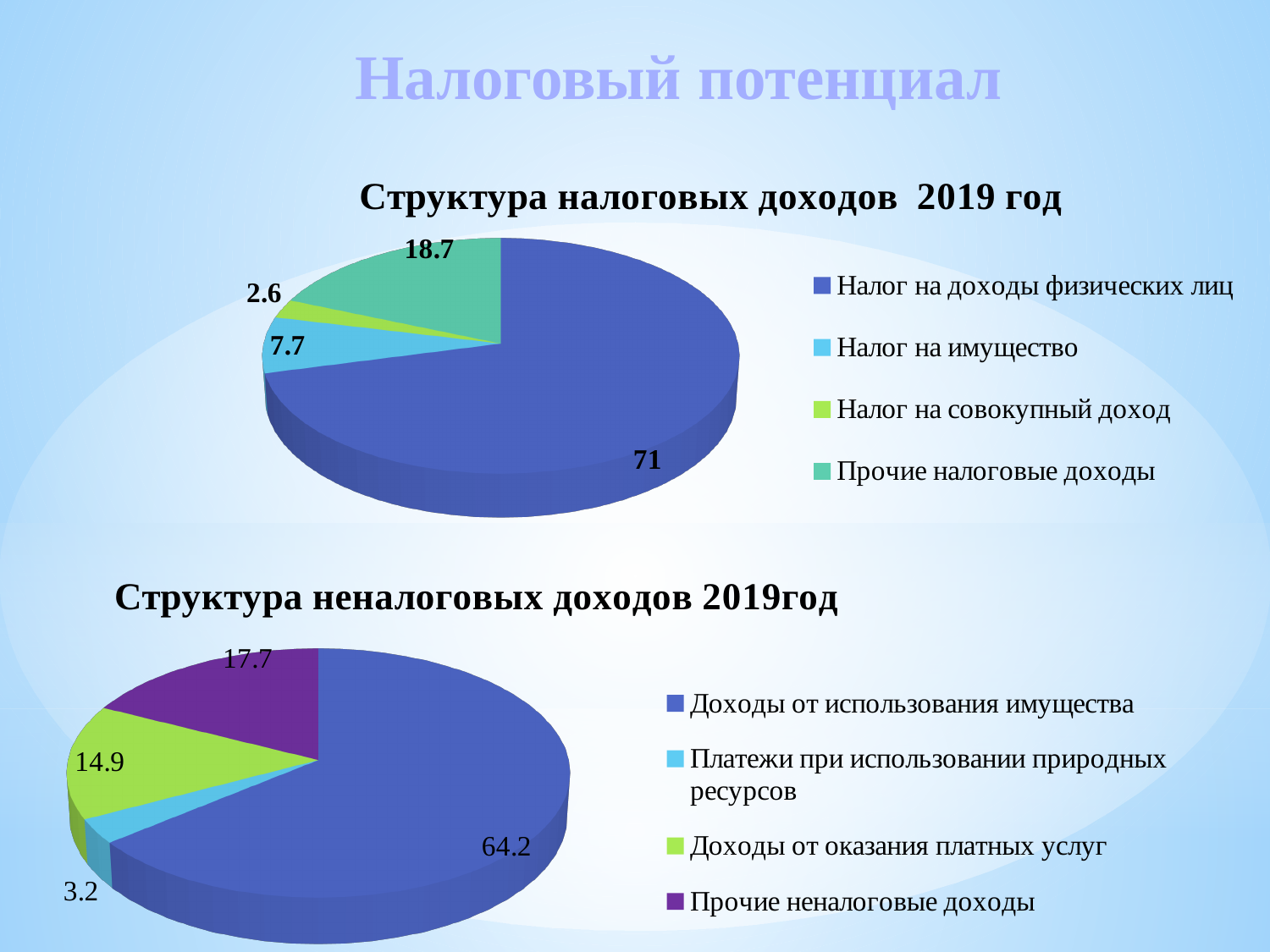
In the chart 'Структура неналоговых доходов 2019год', what is the value for 'Платежи при использовании природных ресурсов'? 3.2 In the chart 'Структура налоговых доходов 2019 год', what is the value for 'Налог на доходы физических лиц'? 71 In the chart 'Структура неналоговых доходов 2019год', what colour is the slice for 'Прочие неналоговые доходы'? Purple In the chart 'Структура неналоговых доходов 2019год', which is larger: 'Прочие неналоговые доходы' or 'Доходы от оказания платных услуг'? Прочие неналоговые доходы In the chart 'Структура налоговых доходов 2019 год', how many categories does the legend list? 4 In the chart 'Структура неналоговых доходов 2019год', what is the difference between 'Прочие неналоговые доходы' and 'Доходы от оказания платных услуг'? 2.8 In the chart 'Структура неналоговых доходов 2019год', what is the value for 'Доходы от использования имущества'? 64.2 In the chart 'Структура налоговых доходов 2019 год', which category has the smallest slice? Налог на совокупный доход In the chart 'Структура неналоговых доходов 2019год', which category has the largest slice? Доходы от использования имущества What type of chart is 'Структура налоговых доходов 2019 год'? Pie chart In the chart 'Структура налоговых доходов 2019 год', what is the value for 'Налог на имущество'? 7.7 In the chart 'Структура налоговых доходов 2019 год', what is the difference between 'Прочие налоговые доходы' and 'Налог на имущество'? 11